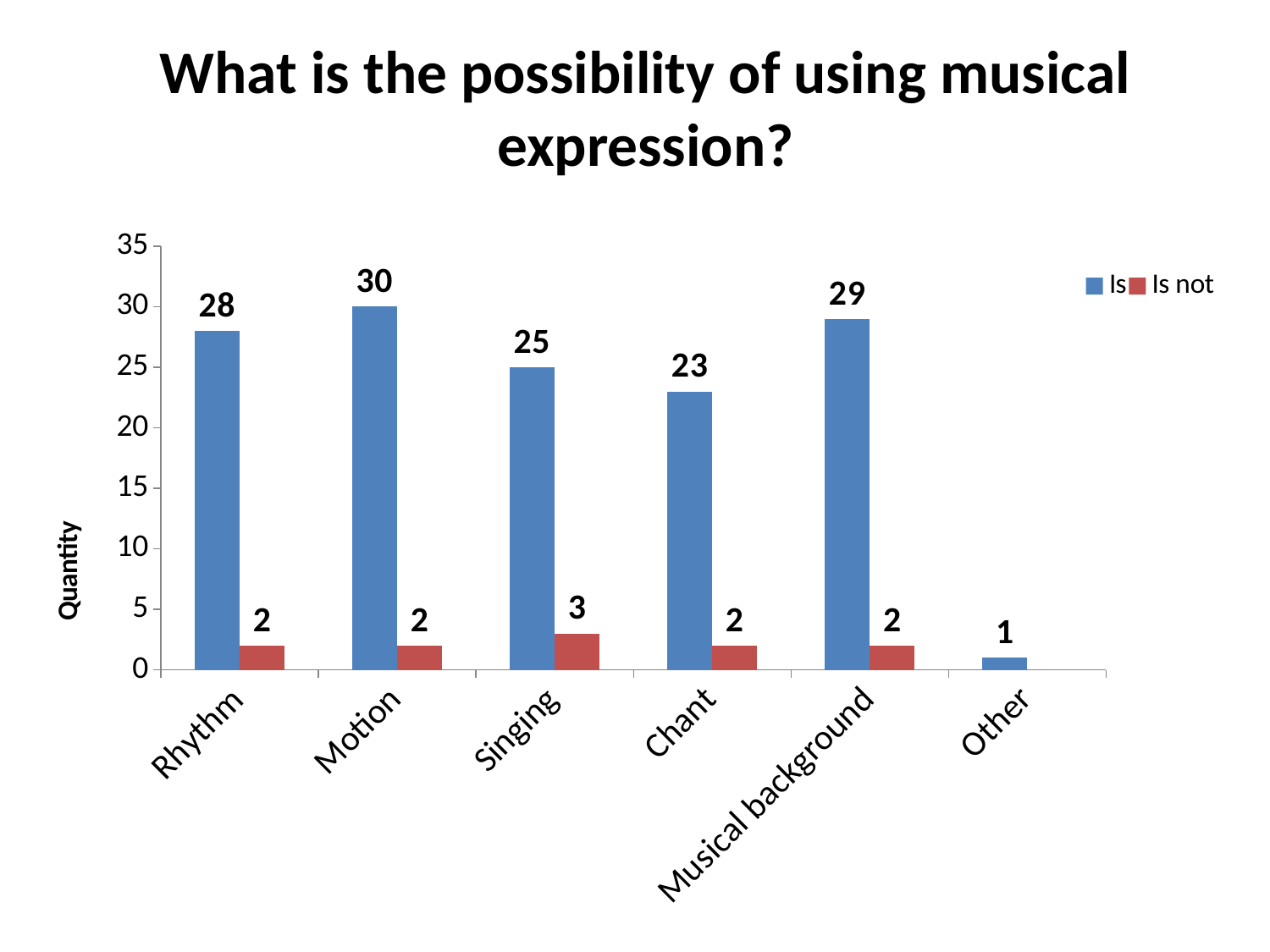
What kind of chart is shown on the slide? Bar chart Which category has the lowest value in the "Is" series? Other Which category has the highest value in the "Is" series? Motion What is the value of the "Is" series for Chant? 23 What is the value of the "Is" series for Motion? 30 What is the difference between the "Is" values for Musical background and Rhythm? 1 What is the value of the "Is not" series for Singing? 3 How many series does the legend list? 2 Which is larger, the "Is" value for Singing or the "Is" value for Chant? Singing How many categories are shown on the x axis? 6 Is the "Is" value for Rhythm greater or less than 25? greater What is the label of the vertical axis? Quantity